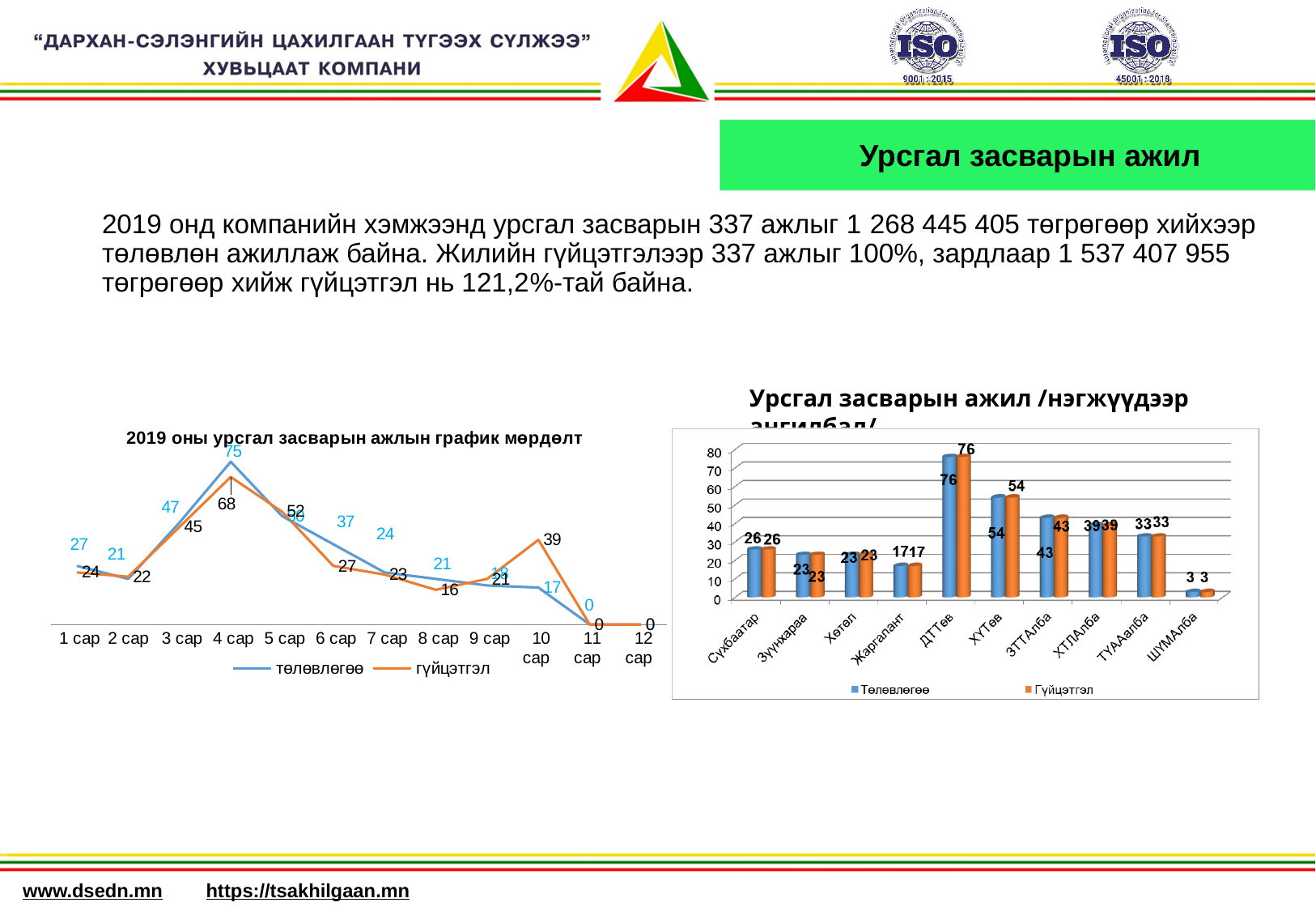
In the chart titled "2019 оны урсгал засварын ажлын график мөрдөлт", what is the гүйцэтгэл value for 10 сар? 39 What kind of chart is the one titled "2019 оны урсгал засварын ажлын график мөрдөлт"? line chart In the chart titled "2019 оны урсгал засварын ажлын график мөрдөлт", how many months are shown on the x axis? 12 In the chart titled "Урсгал засварын ажил /нэгжүүдээр ангилбал/", which category has the lowest Гүйцэтгэл value? ШҮМАлба In the chart titled "Урсгал засварын ажил /нэгжүүдээр ангилбал/", how many categories are shown on the x axis? 10 In the chart titled "Урсгал засварын ажил /нэгжүүдээр ангилбал/", what is the Төлөвлөгөө value for ДТТөв? 76 In the chart titled "2019 оны урсгал засварын ажлын график мөрдөлт", what is the difference between the төлөвлөгөө and гүйцэтгэл values for 4 сар? 7 How many series does the legend of the chart titled "Урсгал засварын ажил /нэгжүүдээр ангилбал/" list? 2 In the chart titled "2019 оны урсгал засварын ажлын график мөрдөлт", what is the гүйцэтгэл value for 4 сар? 68 In the chart titled "2019 оны урсгал засварын ажлын график мөрдөлт", which month has the highest төлөвлөгөө value? 4 сар In the chart titled "2019 оны урсгал засварын ажлын график мөрдөлт", what is the төлөвлөгөө value for 4 сар? 75 In the chart titled "Урсгал засварын ажил /нэгжүүдээр ангилбал/", which is larger: the Гүйцэтгэл value for ХҮТөв or for ЗТТАлба? ХҮТөв